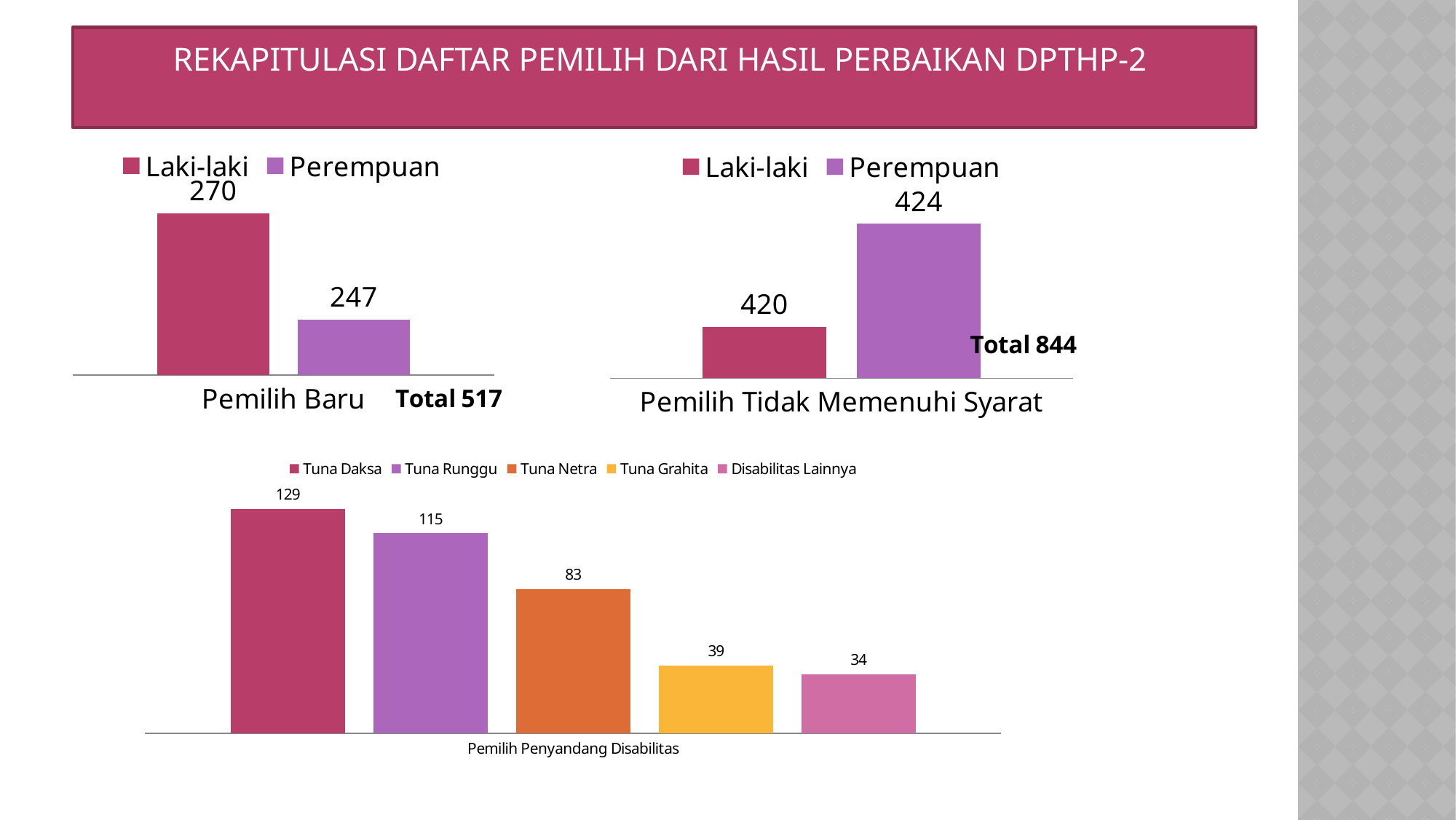
In the Pemilih Penyandang Disabilitas chart, which category has the highest value? Tuna Daksa In the Pemilih Penyandang Disabilitas chart, which category has the lowest value? Disabilitas Lainnya In the Pemilih Penyandang Disabilitas chart, what is the value for Tuna Netra? 83 In the Pemilih Tidak Memenuhi Syarat chart, what total is printed on the slide? Total 844 In the Pemilih Penyandang Disabilitas chart, what is the difference between Tuna Daksa and Tuna Runggu? 14 What kind of chart is the Pemilih Penyandang Disabilitas chart? Bar chart In the Pemilih Baru chart, what is the value for Perempuan? 247 In the Pemilih Tidak Memenuhi Syarat chart, what is the value for Perempuan? 424 In the Pemilih Baru chart, what is the value for Laki-laki? 270 In the Pemilih Baru chart, what is the difference between Laki-laki and Perempuan? 23 In the Pemilih Penyandang Disabilitas chart, how many series does the legend list? 5 In the Pemilih Tidak Memenuhi Syarat chart, what is the value for Laki-laki? 420